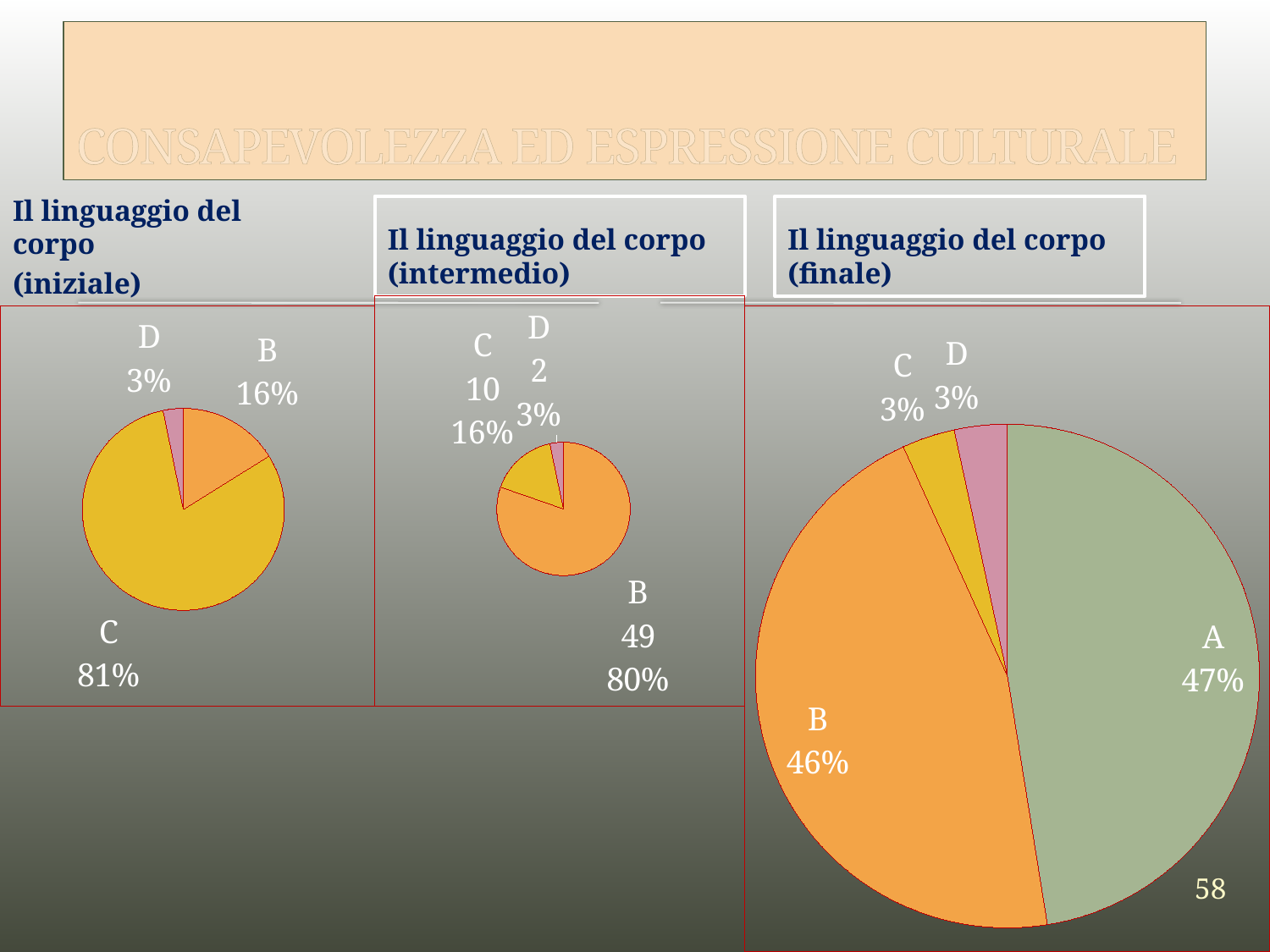
In the 'Il linguaggio del corpo (iniziale)' pie chart, which category has the largest slice? C In the 'Il linguaggio del corpo (intermedio)' pie chart, what count is shown for D? 2 In the 'Il linguaggio del corpo (iniziale)' pie chart, what percentage is shown for B? 16% In the 'Il linguaggio del corpo (intermedio)' pie chart, what percentage is shown for C? 16% How many slices does the 'Il linguaggio del corpo (finale)' pie chart have? 4 What type of chart is used for 'Il linguaggio del corpo (finale)'? Pie chart In the 'Il linguaggio del corpo (intermedio)' pie chart, what count is shown for B? 49 In the 'Il linguaggio del corpo (iniziale)' pie chart, what percentage is shown for C? 81% In the 'Il linguaggio del corpo (intermedio)' pie chart, which category has the smallest slice? D How many slices does the 'Il linguaggio del corpo (iniziale)' pie chart have? 3 In the 'Il linguaggio del corpo (finale)' pie chart, what percentage is shown for A? 47% In the 'Il linguaggio del corpo (finale)' pie chart, what percentage is shown for B? 46%